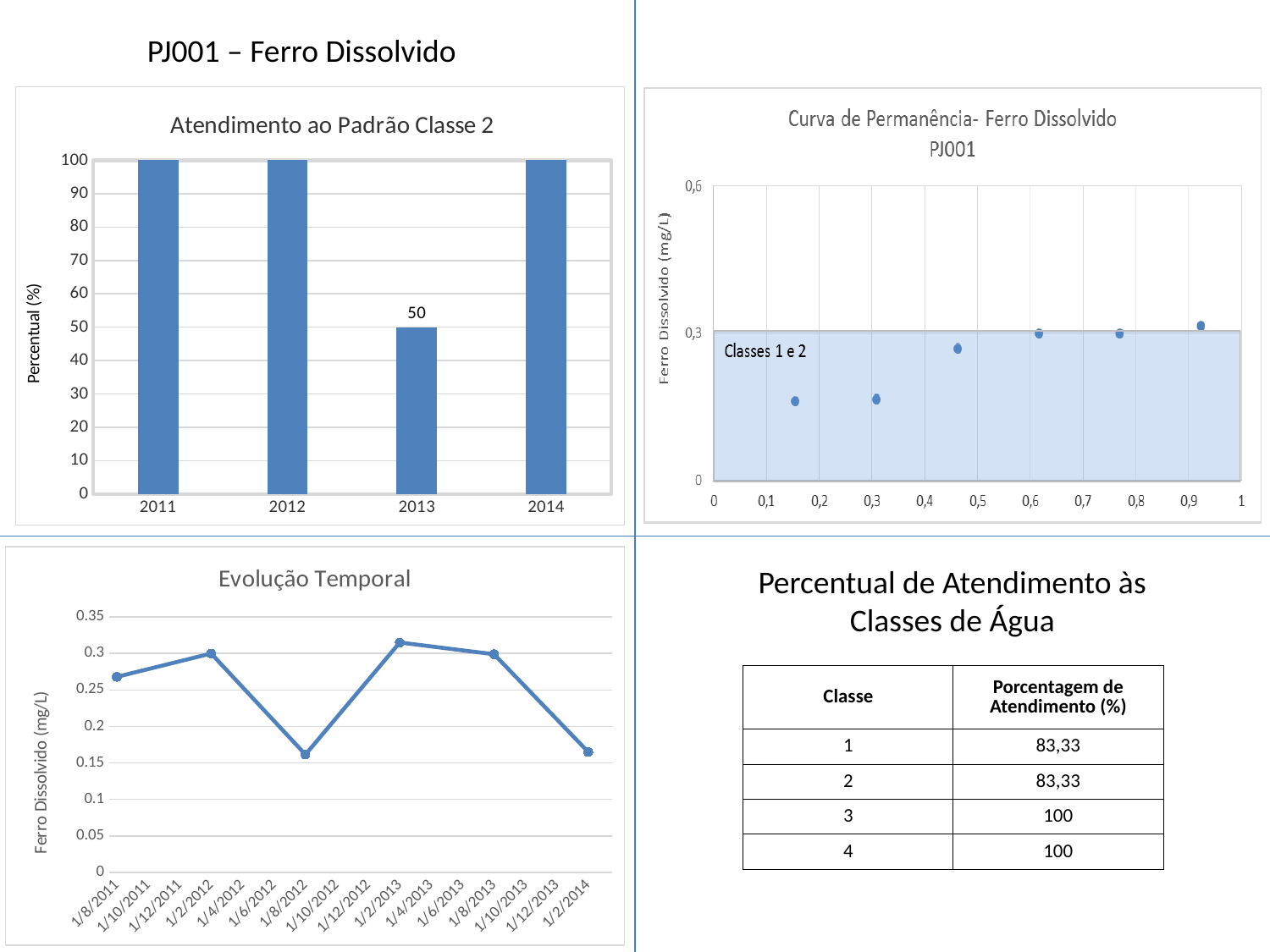
What kind of chart is 'Atendimento ao Padrão Classe 2'? bar chart In the 'Atendimento ao Padrão Classe 2' chart, which is larger, the value for 2014 or the value for 2013? 2014 In the 'Atendimento ao Padrão Classe 2' chart, what is the value for 2011? 100 In the 'Atendimento ao Padrão Classe 2' chart, which year has the lowest value? 2013 In the 'Atendimento ao Padrão Classe 2' chart, what is the difference between the values for 2012 and 2013? 50 In the 'Curva de Permanência- Ferro Dissolvido PJ001' chart, is the value of the leftmost point greater or less than 0,3? less In the 'Evolução Temporal' chart, do the values rise or fall between 1/8/2013 and 1/2/2014? fall In the 'Curva de Permanência- Ferro Dissolvido PJ001' chart, how many data points are plotted? 6 What kind of chart is 'Evolução Temporal'? line chart In the 'Atendimento ao Padrão Classe 2' chart, what is the value for 2013? 50 In the 'Evolução Temporal' chart, is the value at 1/8/2012 greater or less than 0.2? less In the 'Atendimento ao Padrão Classe 2' chart, how many years are shown on the x axis? 4